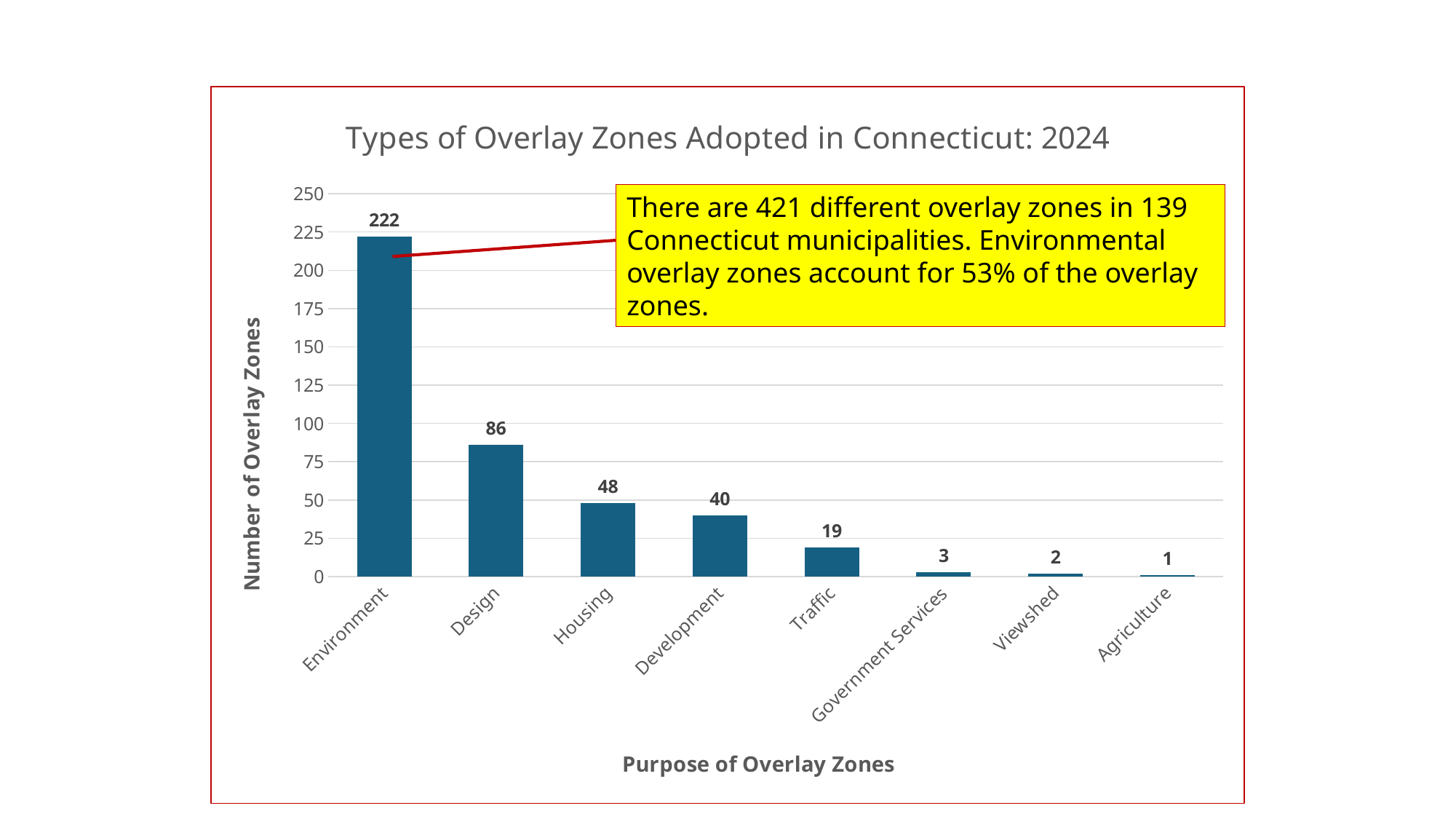
What is the title of the chart? Types of Overlay Zones Adopted in Connecticut: 2024 How many overlay zones are shown for Environment? 222 Which purpose has the lowest number of overlay zones? Agriculture Which purpose has the highest number of overlay zones? Environment What kind of chart is shown on the slide? bar chart What is the difference between the Environment and Design values? 136 Is the value for Design greater or less than 100? less What is the number of overlay zones for Housing? 48 How many purpose categories are shown on the x axis? 8 Which has more overlay zones, Design or Development? Design What is the value for Traffic? 19 What is the difference between the Housing and Development values? 8